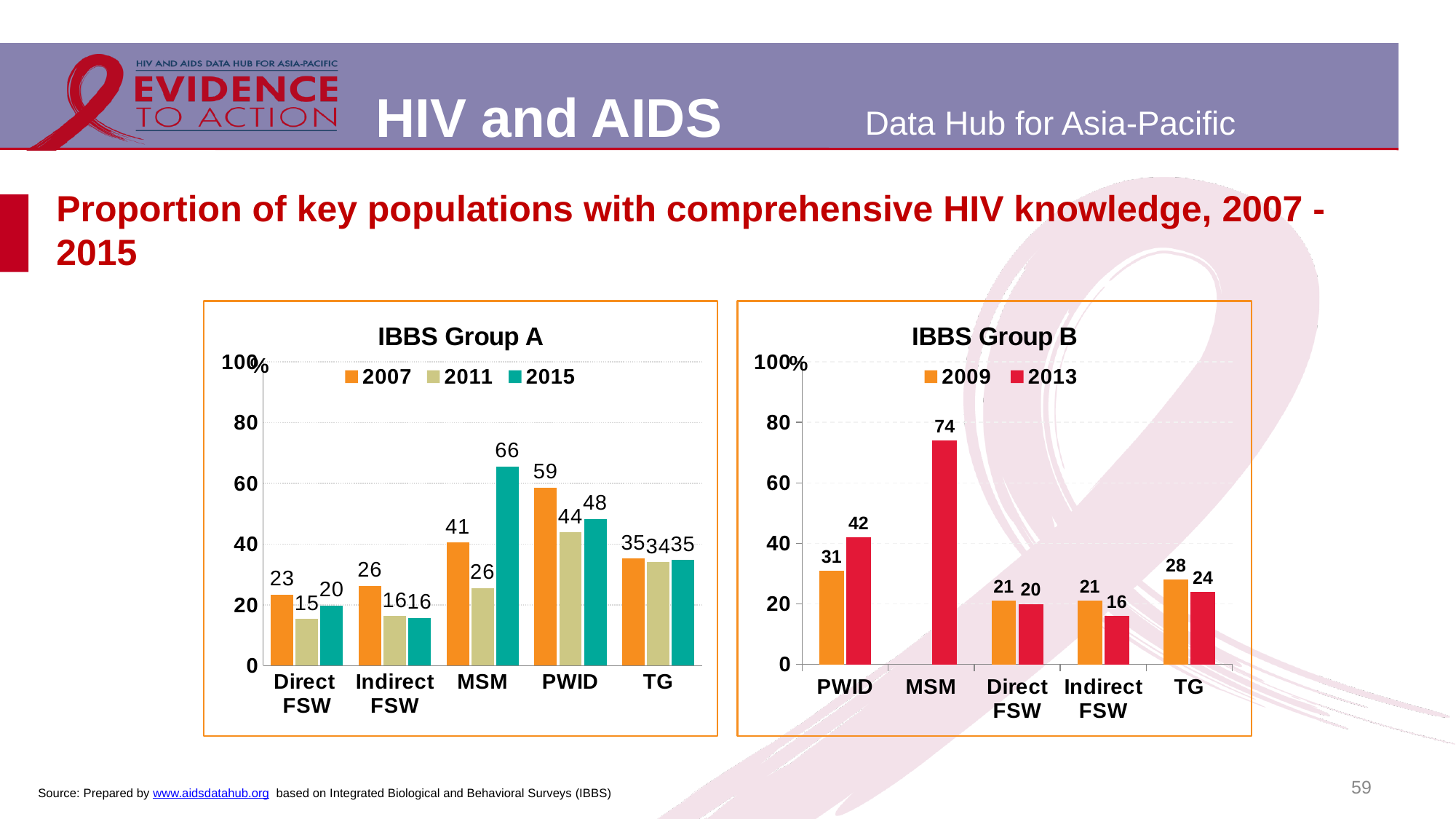
In the IBBS Group A chart, what is the difference between the 2015 and 2011 values for MSM? 40 In the IBBS Group A chart, which population has the lowest value in 2011? Direct FSW In the IBBS Group B chart, which is larger for Indirect FSW: the 2009 value or the 2013 value? 2009 In the IBBS Group B chart, which population has the highest value in 2013? MSM In the IBBS Group B chart, what is the difference between the 2009 and 2013 values for TG? 4 In the IBBS Group A chart, how many population categories are shown on the x axis? 5 In the IBBS Group A chart, which years are listed in the legend? 2007, 2011, 2015 In the IBBS Group A chart, what is the value for MSM in 2015? 66 What type of chart is the IBBS Group A chart? Bar chart In the IBBS Group B chart, what is the value for PWID in 2013? 42 In the IBBS Group B chart, how many series does the legend list? 2 In the IBBS Group A chart, what is the value for PWID in 2007? 59